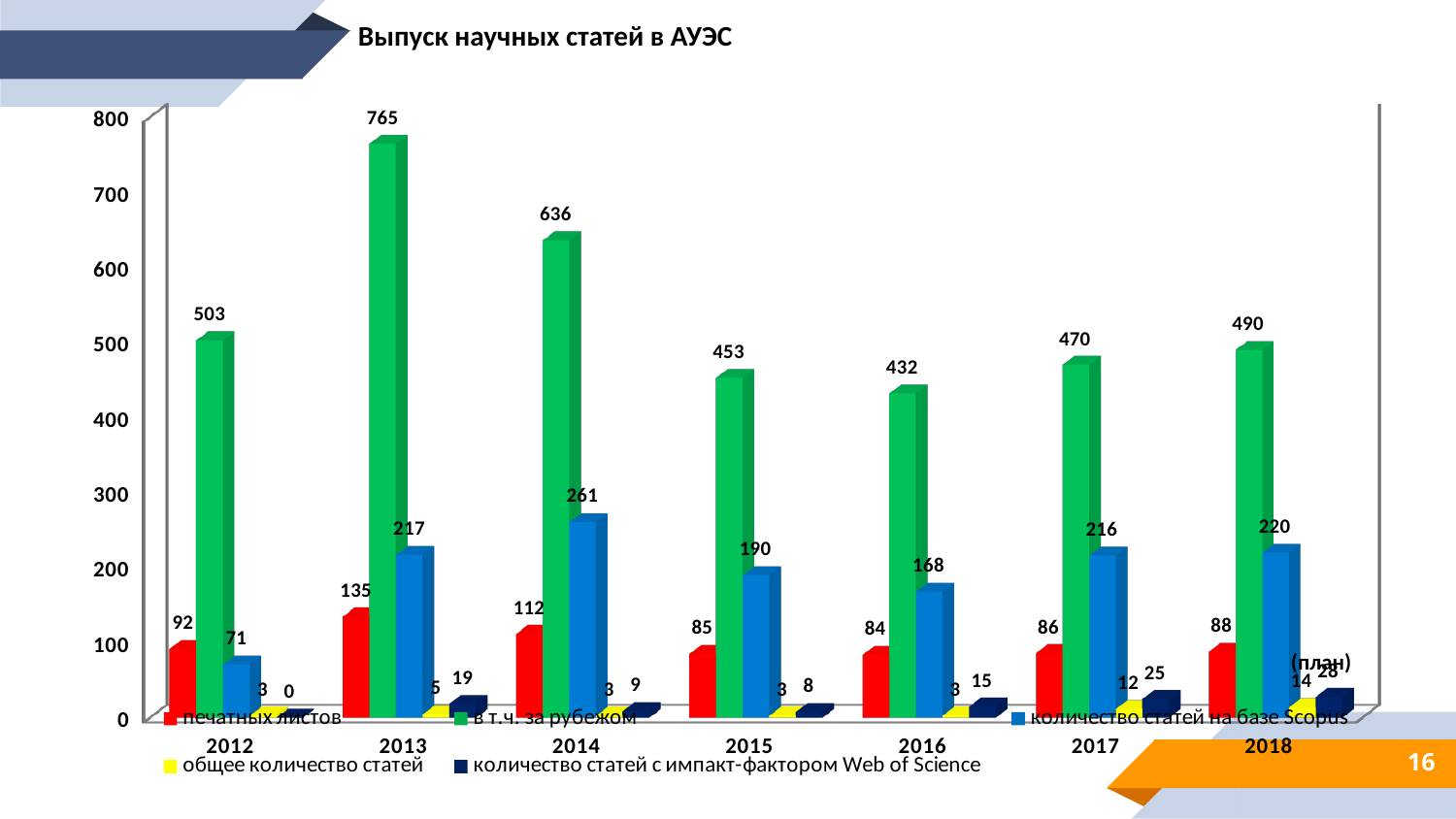
What is the value of the dark blue bar for 2012? 0 In which year is the green bar lowest? 2016 What is the value of the light blue bar for 2014? 261 How many series does the legend list? 5 What is the difference between the green bar values for 2013 and 2014? 129 Which year has the larger red bar, 2012 or 2014? 2014 In which year is the dark blue bar highest? 2018 What is the value of the green bar for 2013? 765 In which year is the green bar highest? 2013 Do the green bar values rise or fall from 2013 to 2016? fall How many years are shown on the x axis? 7 What kind of chart is shown on the slide? bar chart